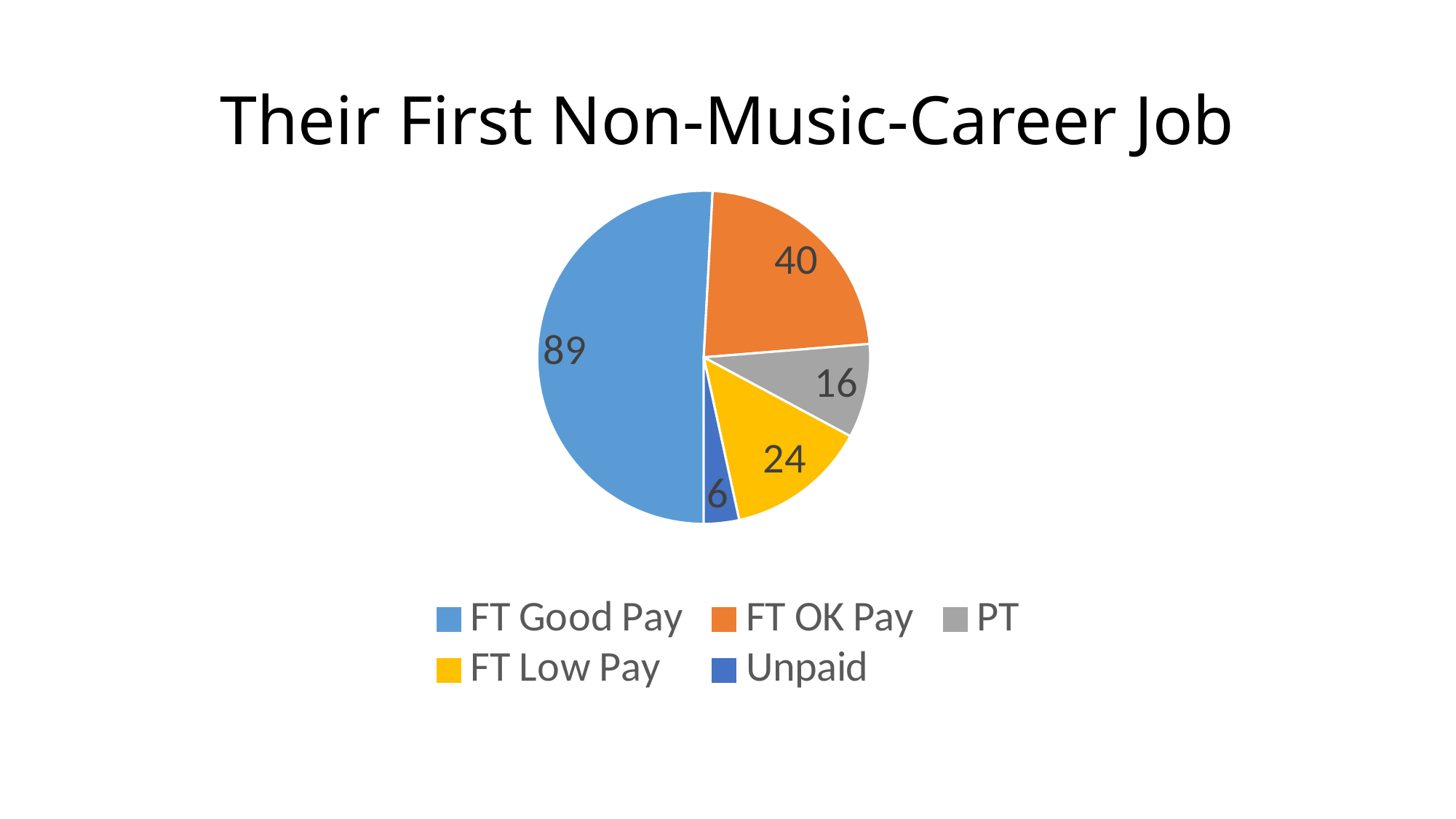
What is the title of the chart? Their First Non-Music-Career Job Which is larger, the FT Low Pay value or the PT value? FT Low Pay Which category has the smallest slice of the pie? Unpaid What is the total of all the slice values in the pie chart? 175 What value is shown for the FT Good Pay slice? 89 What value is shown for the Unpaid slice? 6 What kind of chart is shown on the slide? Pie chart Which category has the largest slice of the pie? FT Good Pay How many categories does the pie chart show? 5 What is the difference between the FT Good Pay value and the FT OK Pay value? 49 What value is shown for the FT OK Pay slice? 40 What value is shown for the PT slice? 16